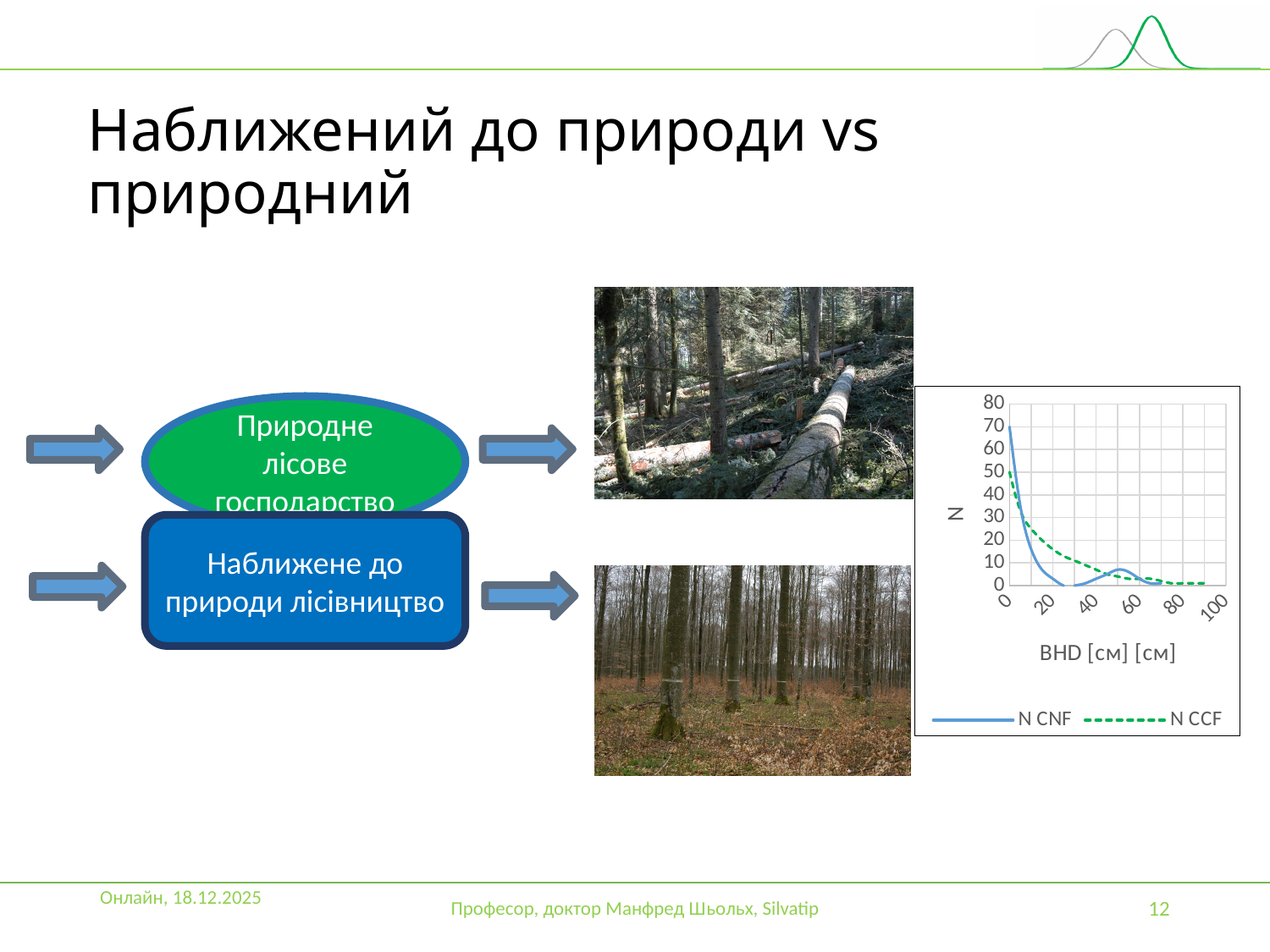
Is the value of N CNF at BHD 0 greater or less than 60? greater Is the value of N CNF at BHD 60 greater or less than 20? less What is the highest tick value shown on the chart's y axis? 80 What is the label of the chart's x axis? BHD [см] [см] How many series does the chart legend list? 2 At BHD 20, which series has the larger value, N CNF or N CCF? N CCF Is the value of N CCF at BHD 0 greater or less than 60? less At BHD 0, which series has the larger value, N CNF or N CCF? N CNF Which series reaches the highest value on the chart? N CNF Does the N CCF series rise or fall as BHD increases? fall What are the two series named in the chart legend? N CNF and N CCF What kind of chart is shown on the slide? line chart